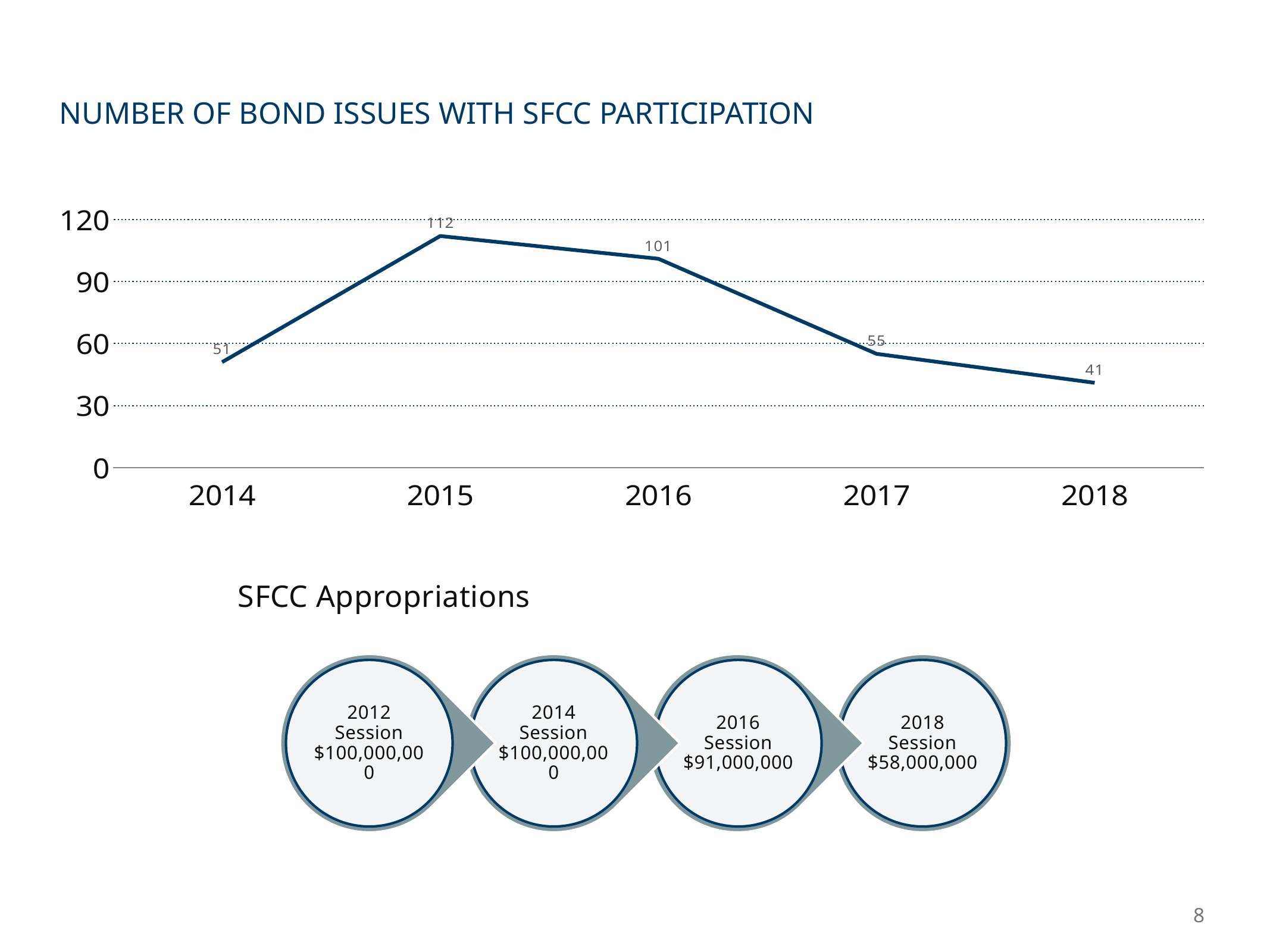
Which year has the highest number of bond issues with SFCC participation? 2015 What is the number of bond issues with SFCC participation in 2014? 51 What kind of chart is shown on the slide? line chart What is the number of bond issues with SFCC participation in 2015? 112 What is the number of bond issues with SFCC participation in 2018? 41 Which year has more bond issues with SFCC participation, 2014 or 2017? 2017 Which year has the lowest number of bond issues with SFCC participation? 2018 Is the value for 2016 greater or less than 90? greater How many years are plotted on the chart? 5 What is the difference between the number of bond issues in 2017 and in 2018? 14 Do the values rise or fall from 2015 to 2018? fall What is the difference between the number of bond issues in 2015 and in 2016? 11